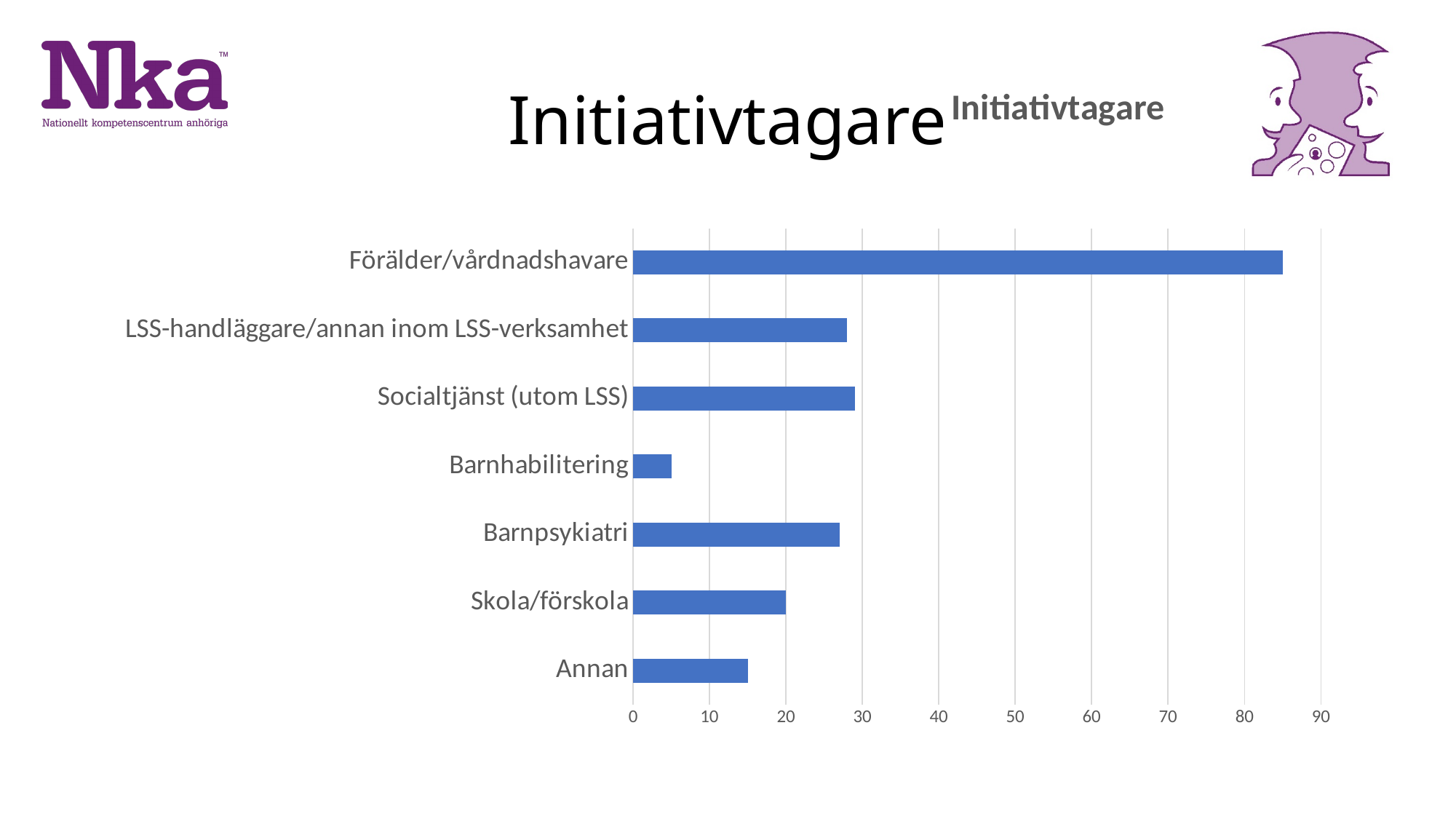
Is the value for Barnhabilitering greater or less than 10? less Is the value for Annan greater or less than 20? less What type of chart is shown on the slide? bar chart What colour are the bars in the chart? blue Which is larger, the value for Barnpsykiatri or the value for Annan? Barnpsykiatri Which category has the highest value? Förälder/vårdnadshavare What is the title of the chart? Initiativtagare Which category has the lowest value? Barnhabilitering Is the value for Förälder/vårdnadshavare greater or less than 80? greater Which is larger, the value for Skola/förskola or the value for Barnhabilitering? Skola/förskola How many categories are shown in the chart? 7